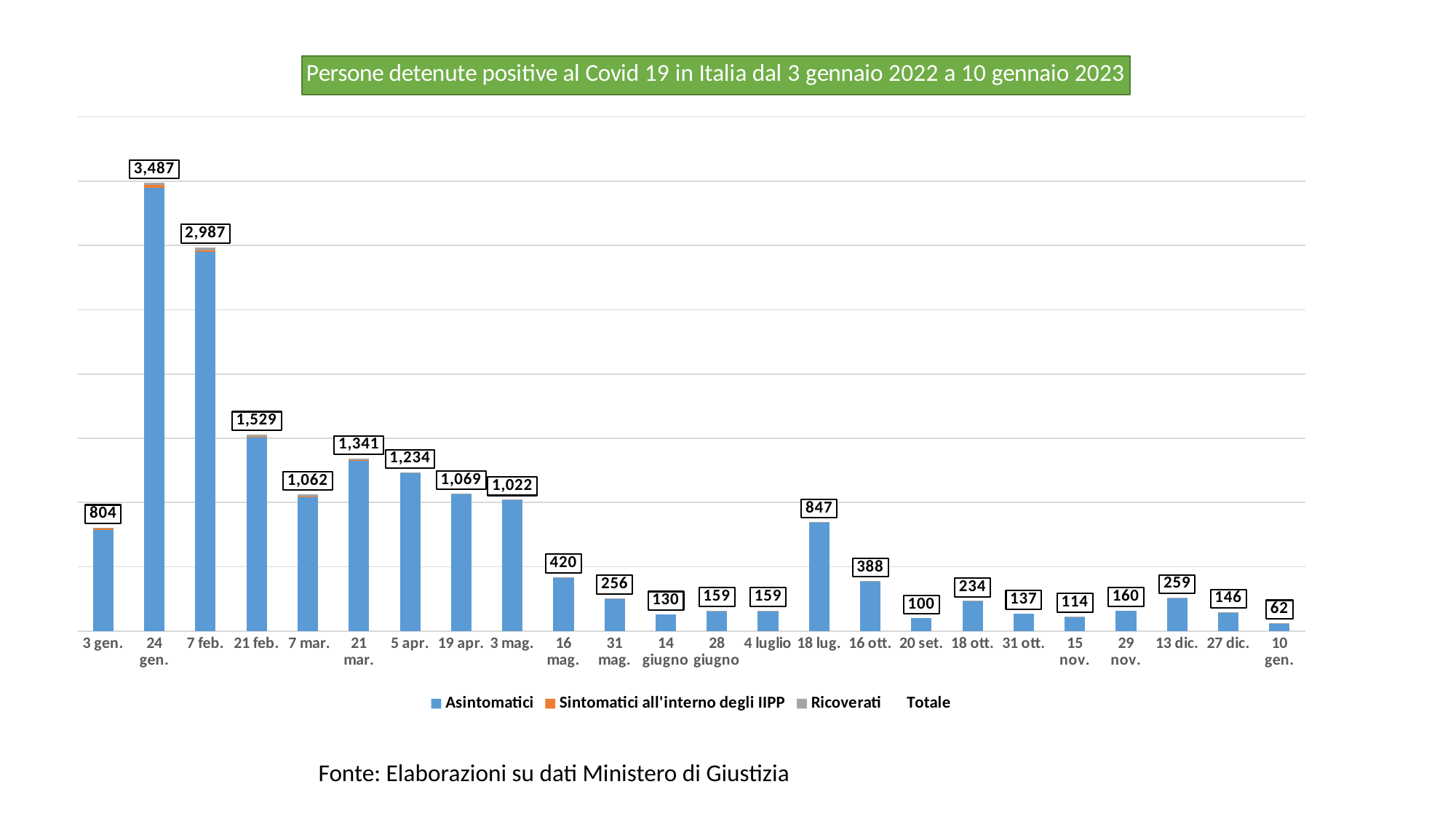
What kind of chart is this? Stacked bar chart Which is larger, the total for 21 mar. or the total for 5 apr.? 21 mar. What is the difference between the totals for 24 gen. and 7 feb.? 500 How many entries does the legend list? 4 What is the difference between the totals for 3 gen. and 16 mag.? 384 How many dates are shown on the x axis? 24 Which date has the highest total? 24 gen. What is the total value shown for 10 gen.? 62 What is the source cited below the chart? Elaborazioni su dati Ministero di Giustizia What is the total value shown for 18 lug.? 847 What is the total value shown for 24 gen.? 3,487 Which date has the lowest total? 10 gen.